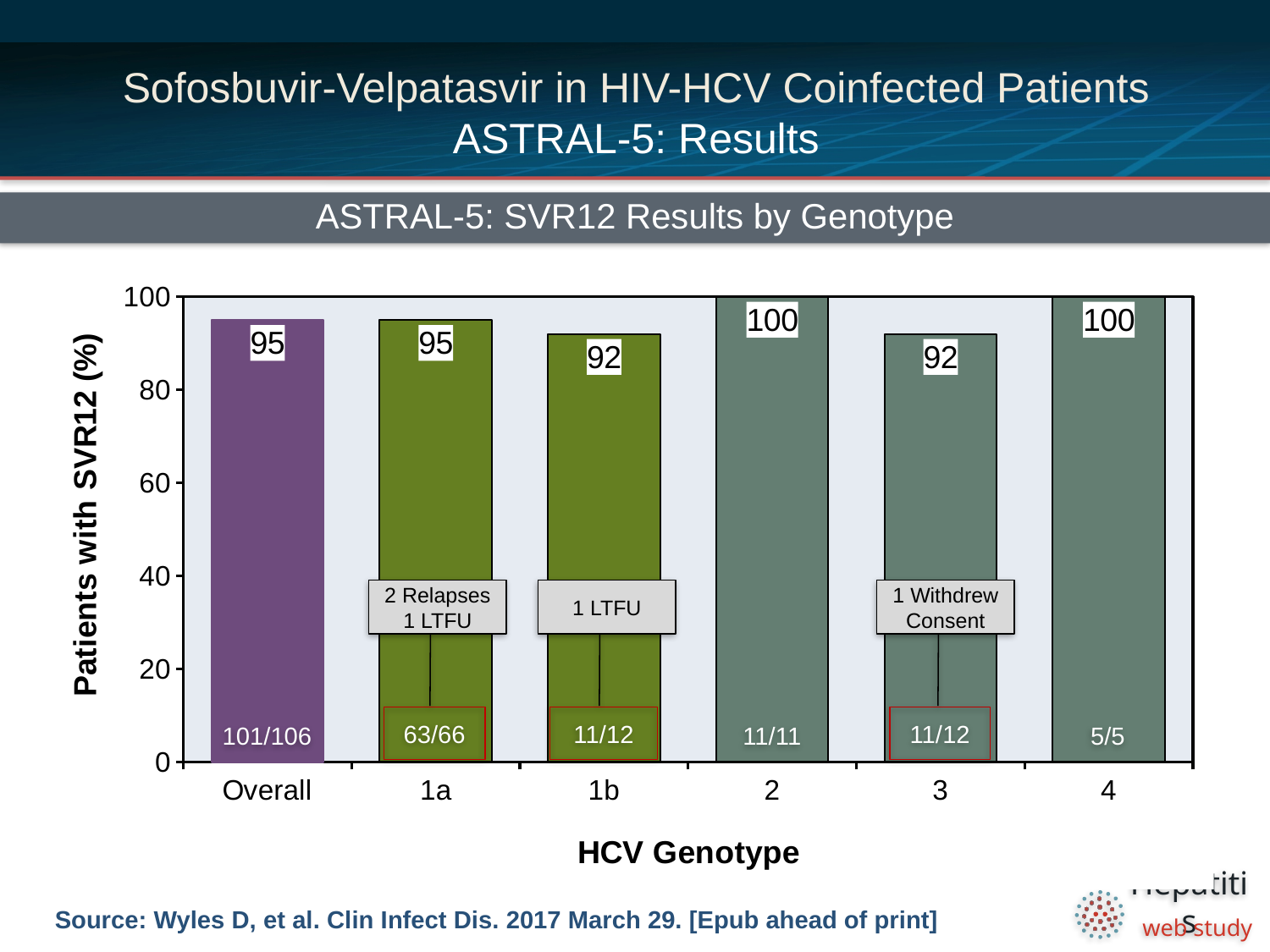
What is the SVR12 rate for the Overall group? 95 What is the label of the y axis? Patients with SVR12 (%) Which genotypes have the lowest SVR12 rate? 1b and 3 What is the SVR12 rate for genotype 1b? 92 Is the SVR12 rate for genotype 1a greater or less than 80? greater What fraction of patients achieved SVR12 in the Overall group? 101/106 Which genotypes have the highest SVR12 rate? 2 and 4 What is the difference in SVR12 rate between genotype 2 and genotype 3? 8 How many categories are shown on the x axis? 6 What fraction of patients achieved SVR12 in genotype 1a? 63/66 What is the SVR12 rate for genotype 2? 100 What kind of chart is shown on the slide? Bar chart